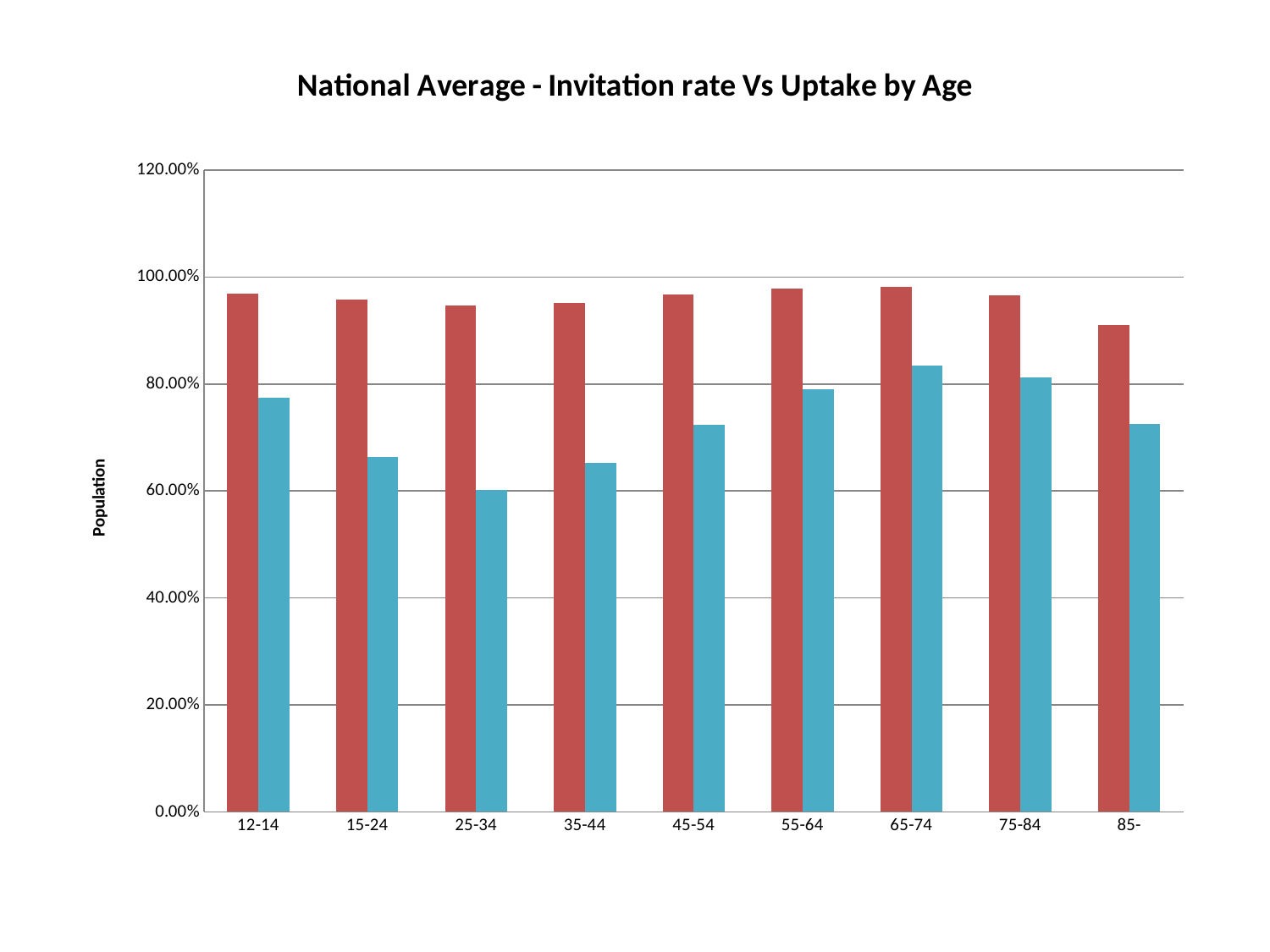
Is the blue bar for 65-74 greater or less than 80.00%? greater Which age group has the lowest blue bar? 25-34 What type of chart is shown on the slide? bar chart Which age group has the highest blue bar? 65-74 What is the label on the vertical axis of the chart? Population Is the blue bar for 12-14 greater or less than 80.00%? less What is the title of the chart? National Average - Invitation rate Vs Uptake by Age Which age group has the lowest red bar? 85- For the 45-54 age group, which bar is taller, the red bar or the blue bar? the red bar Is the red bar for 85- greater or less than 100.00%? less How many bars are plotted for each age group? 2 How many age groups are shown on the x axis? 9